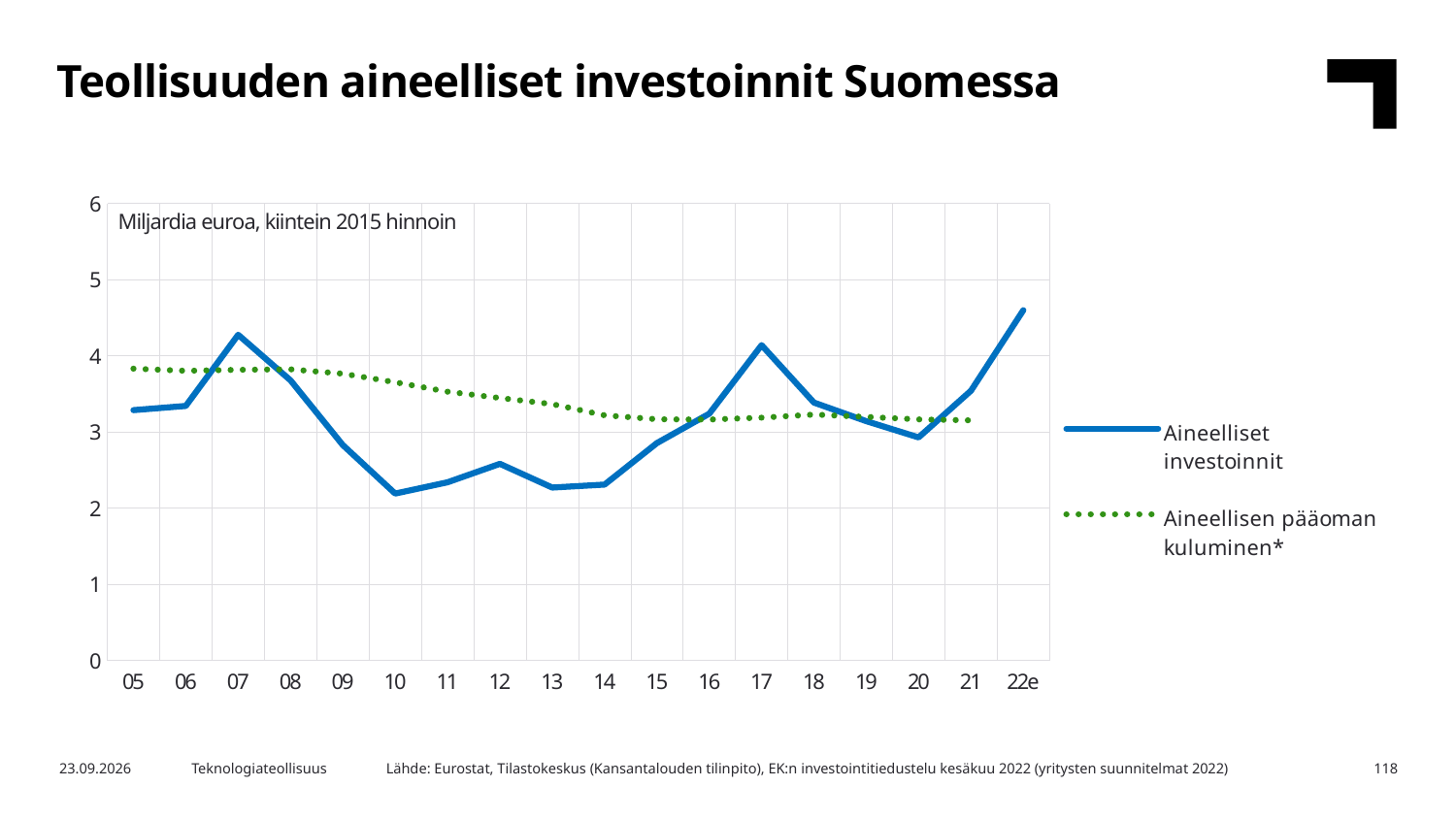
Which year has the larger value for Aineelliset investoinnit: 07 or 09? 07 Is the value for Aineelliset investoinnit in 22e greater or less than 4? greater Which is larger in 05: Aineelliset investoinnit or Aineellisen pääoman kuluminen*? Aineellisen pääoman kuluminen* Is the value for Aineelliset investoinnit in 07 greater or less than 4? greater How many years are shown on the x axis? 18 What kind of chart is shown on the slide? line chart Is the value for Aineellisen pääoman kuluminen* in 05 greater or less than 3.5? greater How many series does the legend list? 2 In which year is the value for Aineelliset investoinnit highest? 22e Does the Aineellisen pääoman kuluminen* line rise or fall from 05 to 15? fall What unit is stated in the text inside the chart area? Miljardia euroa, kiintein 2015 hinnoin